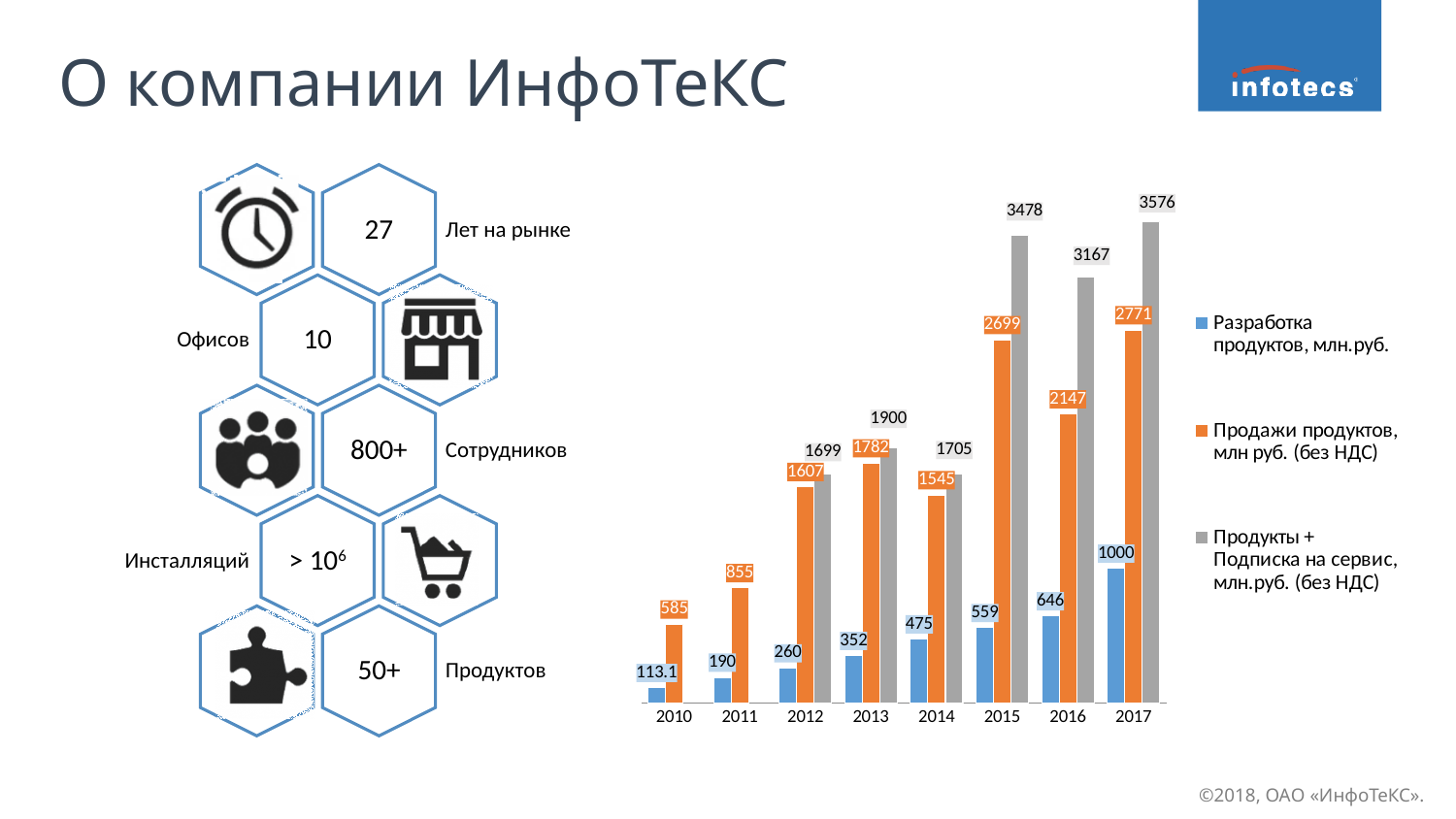
Which is larger: Продажи продуктов, млн руб. (без НДС) in 2013 or in 2014? 2013 What is the value of Разработка продуктов, млн.руб. for 2017? 1000 How many years are shown on the x axis of the chart? 8 What is the difference between Продажи продуктов, млн руб. (без НДС) in 2017 and in 2016? 624 What is the value of Продукты + Подписка на сервис, млн.руб. (без НДС) for 2016? 3167 In which year is Разработка продуктов, млн.руб. lowest? 2010 In which year is Продукты + Подписка на сервис, млн.руб. (без НДС) highest? 2017 What kind of chart is shown on the slide? bar chart Does Разработка продуктов, млн.руб. rise or fall from 2010 to 2017? rise What is the value of Продажи продуктов, млн руб. (без НДС) for 2015? 2699 What colour are the bars for Продажи продуктов, млн руб. (без НДС)? orange How many series does the chart legend list? 3